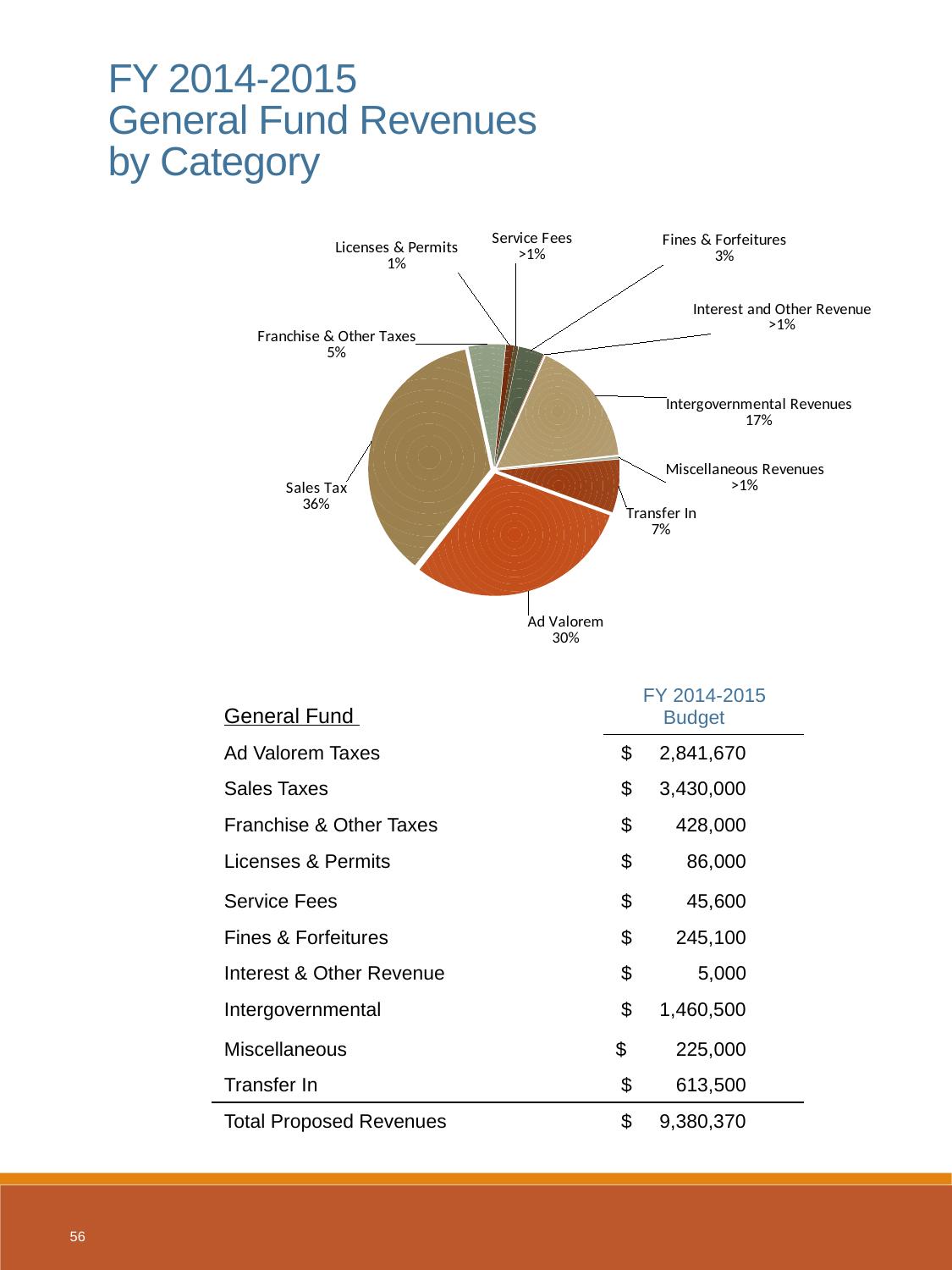
How many categories are shown in the pie chart? 10 Which category has the largest slice of the pie? Sales Tax Which slice is larger, Intergovernmental Revenues or Transfer In? Intergovernmental Revenues What share of the pie does Sales Tax represent? 36% What percentage is shown for Franchise & Other Taxes in the pie chart? 5% What percentage is shown for Fines & Forfeitures in the pie chart? 3% What percentage label is shown for Service Fees in the pie chart? >1% What percentage is shown for Transfer In in the pie chart? 7% What percentage is shown for Intergovernmental Revenues in the pie chart? 17% What kind of chart is shown on the slide? pie chart What share of the pie does Ad Valorem represent? 30% How many percentage points larger is the Sales Tax share than the Ad Valorem share? 6